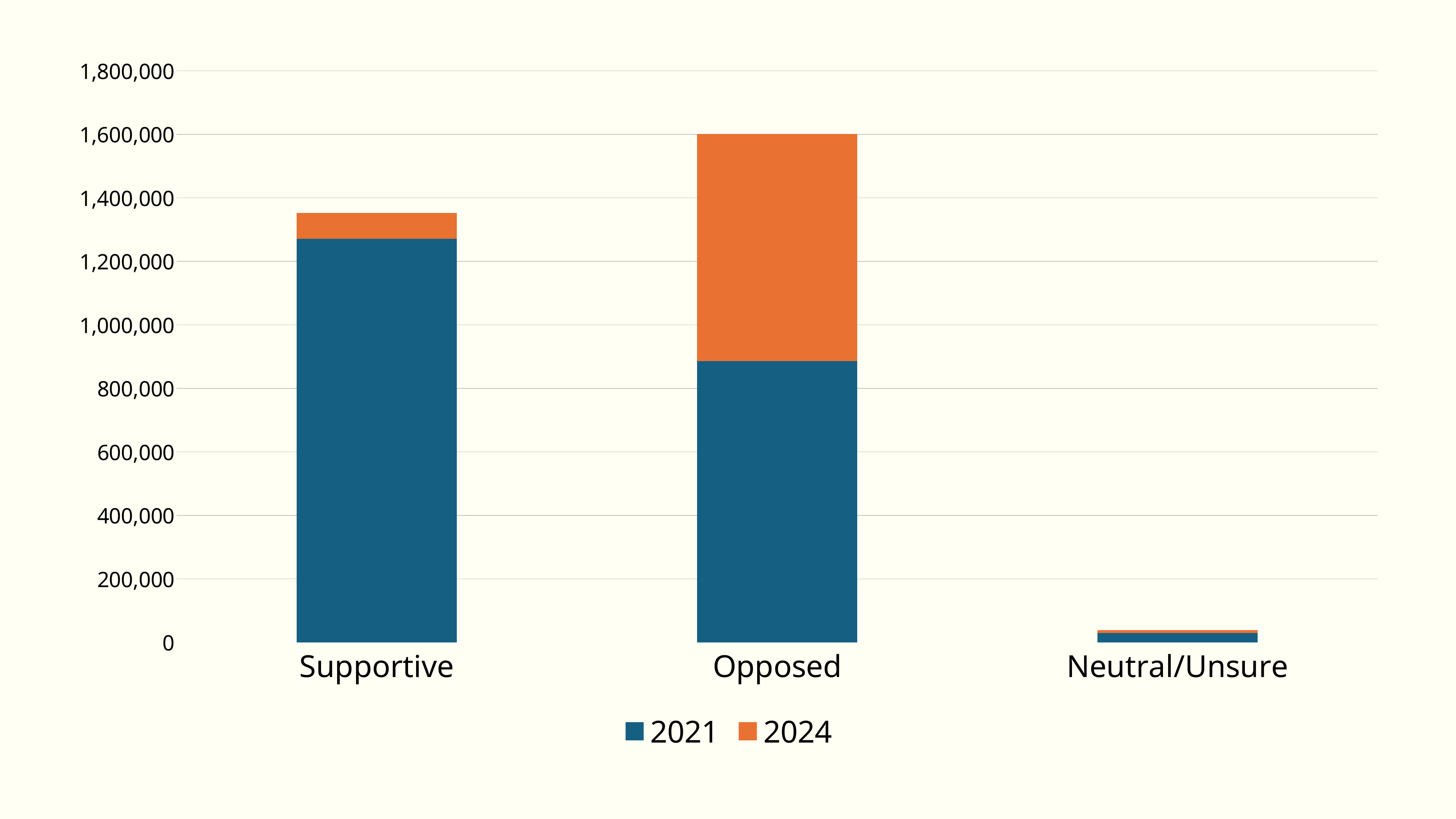
How many categories are shown on the x axis? 3 Is the 2021 value for Supportive greater or less than 1,200,000? greater Which is larger for the 2021 series: Supportive or Opposed? Supportive What kind of chart is shown on the slide? Stacked bar chart Which is larger for the 2024 series: Supportive or Opposed? Opposed Which category has the tallest stacked bar? Opposed Which colour represents the 2024 series in the legend? Orange Is the total of the stacked bar for Neutral/Unsure greater or less than 200,000? less Which category has the shortest stacked bar? Neutral/Unsure Is the 2021 value for Opposed greater or less than 1,000,000? less How many series does the legend list? 2